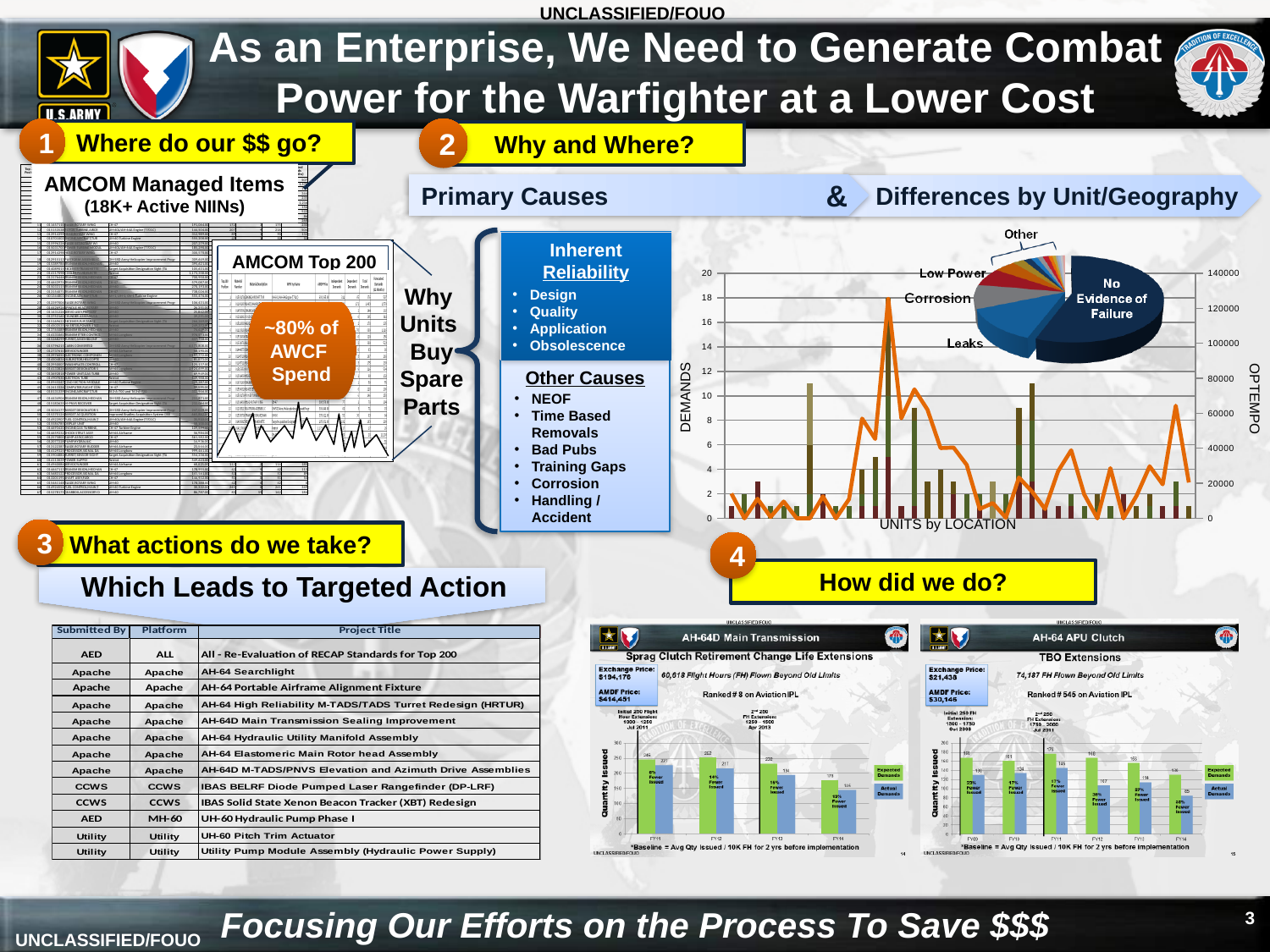
In the pie chart in the upper right, is the slice for No Evidence of Failure larger or smaller than the slice for Leaks? Larger In the pie chart in the upper right, how many slices have a text label? 5 In the pie chart in the upper right, which category has the largest slice? No Evidence of Failure What kind of chart is the chart in the upper right showing Other, Low Power, Corrosion, Leaks and No Evidence of Failure? Pie chart On the DEMANDS chart under 'Differences by Unit/Geography', is the tallest bar greater or less than 8 on the left axis? greater What is the title of the chart in the bottom-right panel next to 'AH-64D Main Transmission'? AH-64 APU Clutch What is the label of the left vertical axis on the DEMANDS chart under 'Differences by Unit/Geography'? DEMANDS What is the label of the right vertical axis on the DEMANDS chart under 'Differences by Unit/Geography'? OP TEMPO What kind of chart is shown in the 'AH-64D Main Transmission' panel at the bottom of the slide? Bar chart On the DEMANDS chart under 'Differences by Unit/Geography', what is the highest tick value shown on the right axis? 140000 On the DEMANDS chart under 'Differences by Unit/Geography', what is the highest tick value shown on the left axis? 20 On the DEMANDS chart under 'Differences by Unit/Geography', is the peak of the orange line greater or less than 16 on the left axis? greater